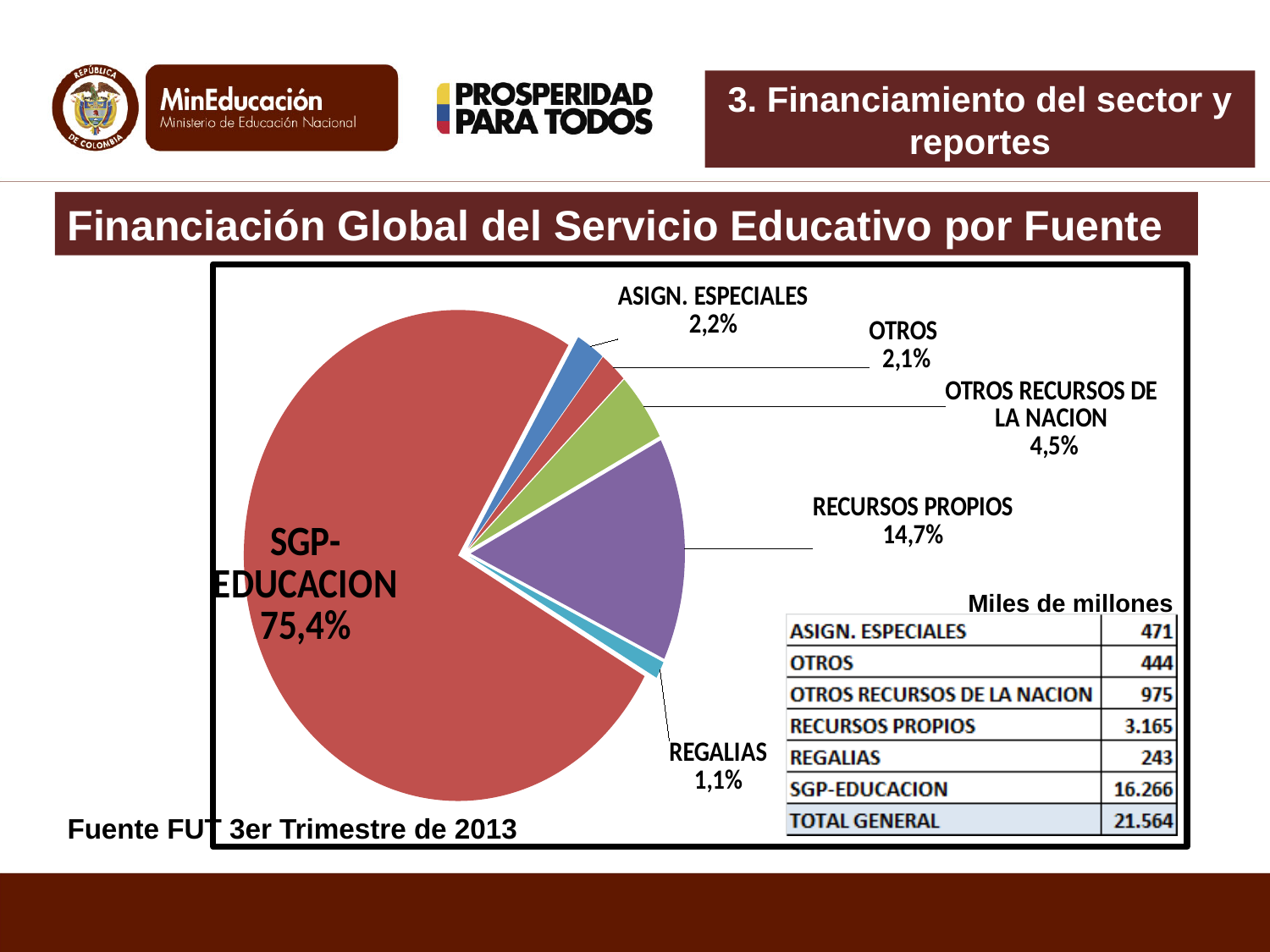
Which has a larger share, RECURSOS PROPIOS or OTROS RECURSOS DE LA NACION? RECURSOS PROPIOS What share of the pie does SGP-EDUCACION represent? 75,4% According to the table next to the pie chart, what is the value for RECURSOS PROPIOS in miles de millones? 3.165 What share of the pie does OTROS RECURSOS DE LA NACION represent? 4,5% What is the title of the chart on the slide? Financiación Global del Servicio Educativo por Fuente What share of the pie does RECURSOS PROPIOS represent? 14,7% Which source has the largest share of the pie? SGP-EDUCACION What is the difference in percentage points between the RECURSOS PROPIOS share and the OTROS RECURSOS DE LA NACION share? 10,2 How many slices does the pie chart have? 6 What kind of chart is shown on the slide? pie chart Which source has the smallest share of the pie? REGALIAS